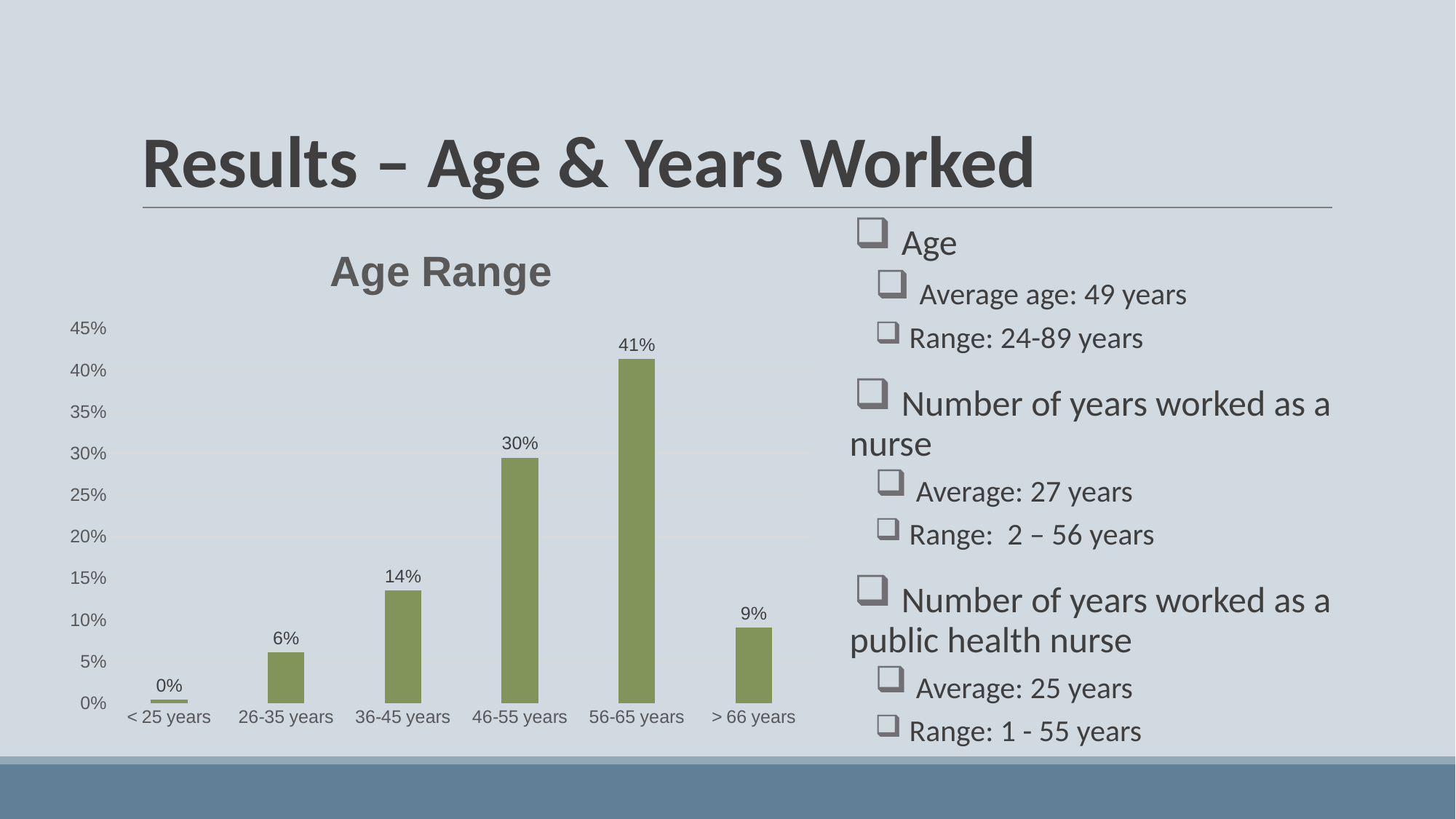
What is the value for the 26-35 years category? 6% What is the value for the 36-45 years category? 14% What is the value for the 56-65 years category? 41% Which age range has the highest value? 56-65 years What is the value for the > 66 years category? 9% What kind of chart is shown on the slide? bar chart Is the value for 46-55 years greater or less than 25%? greater What is the title of the chart? Age Range Which is larger, the value for 26-35 years or the value for > 66 years? > 66 years Which age range has the lowest value? < 25 years What is the difference between the values for 56-65 years and 46-55 years? 11% How many age range categories are shown on the chart? 6